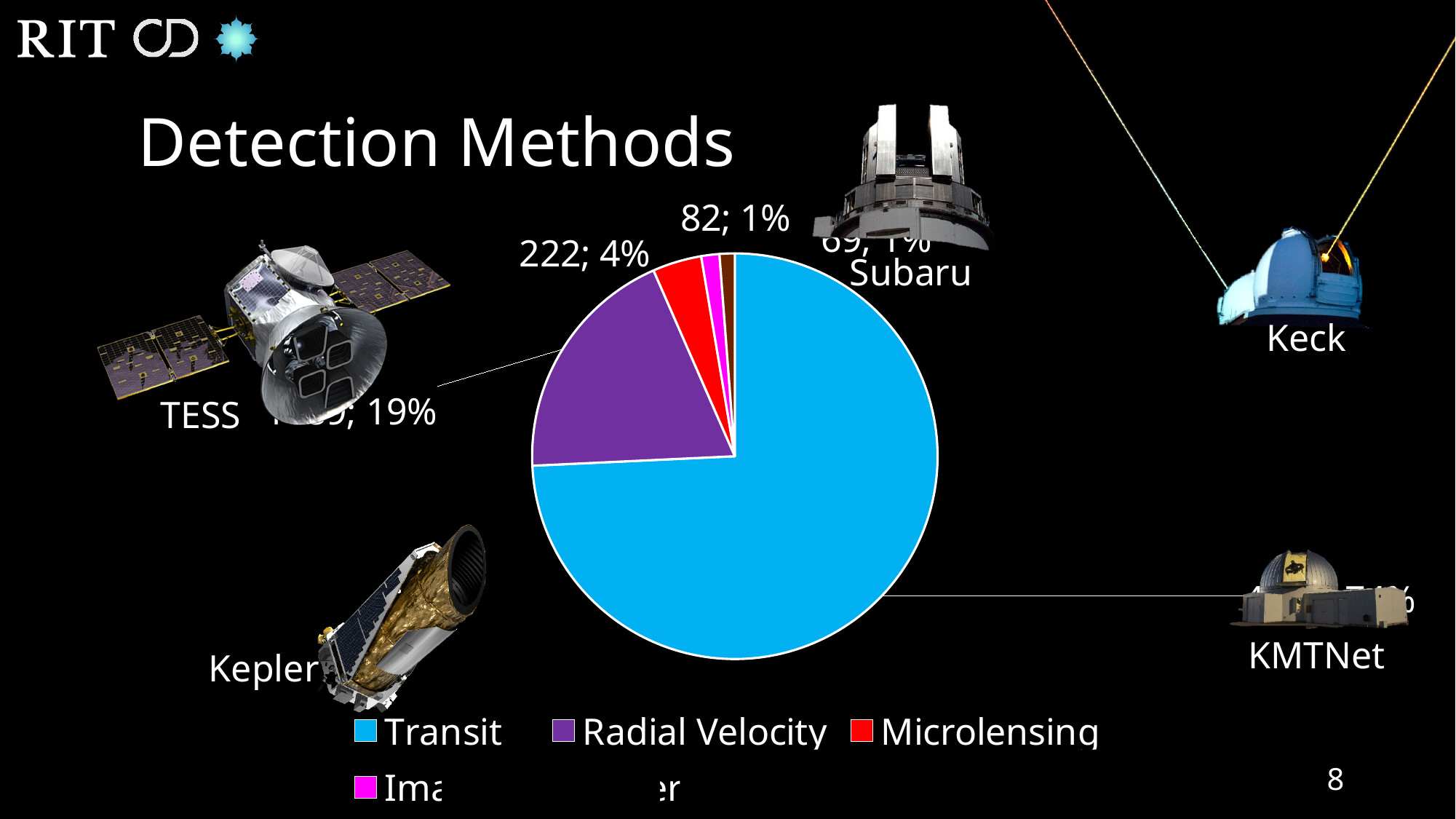
What is the difference between the Microlensing count (222) and the magenta slice count (82)? 140 Which is larger, the Microlensing slice (222) or the magenta slice (82)? Microlensing What share of the pie does the magenta slice represent? 1% What value is labelled on the magenta slice? 82; 1% What colour is the Transit slice? blue What value is labelled on the Microlensing slice? 222; 4% What share of the pie does the Microlensing slice represent? 4% Which is larger, the Transit slice or the Radial Velocity slice? Transit Which detection method has the largest slice of the pie? Transit What kind of chart is shown on the slide? pie chart What is the title of the chart? Detection Methods How many slices does the pie chart have? 5